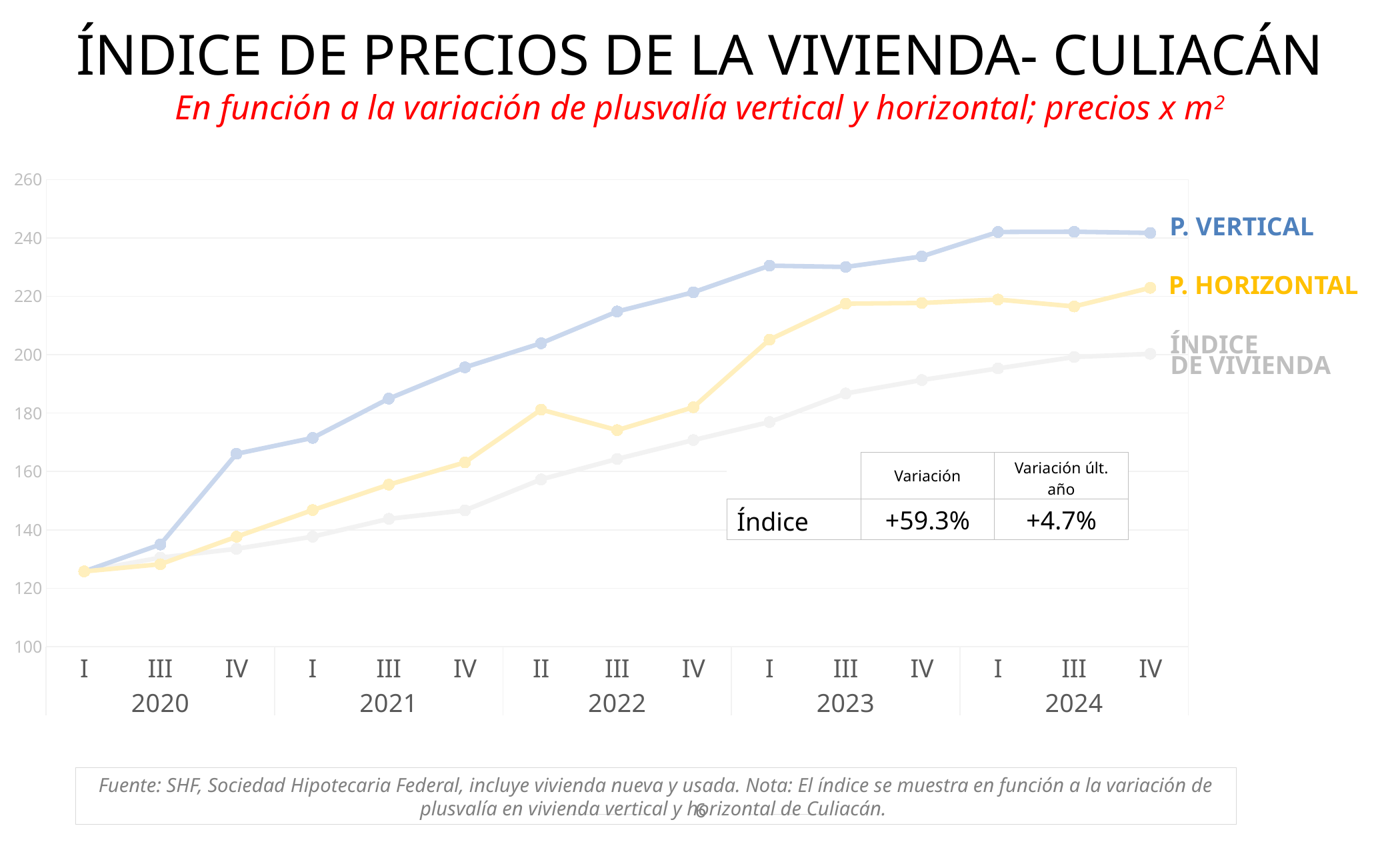
Which series has the lowest value at IV 2024? ÍNDICE DE VIVIENDA How many series are plotted on the chart? 3 According to the table on the chart, what is the 'Variación' for the Índice? +59.3% Does the P. VERTICAL line generally rise or fall from I 2020 to IV 2024? rise Which series has the highest value at IV 2024? P. VERTICAL Is the value of P. HORIZONTAL at I 2020 greater or less than 140? less What kind of chart is shown on the slide? line chart What is the title of the chart? ÍNDICE DE PRECIOS DE LA VIVIENDA- CULIACÁN How many data points does each line have along the x axis? 15 At III 2022, which is higher: P. HORIZONTAL or ÍNDICE DE VIVIENDA? P. HORIZONTAL Is the value of P. VERTICAL at IV 2024 greater or less than 220? greater Is the value of ÍNDICE DE VIVIENDA at IV 2024 greater or less than 180? greater